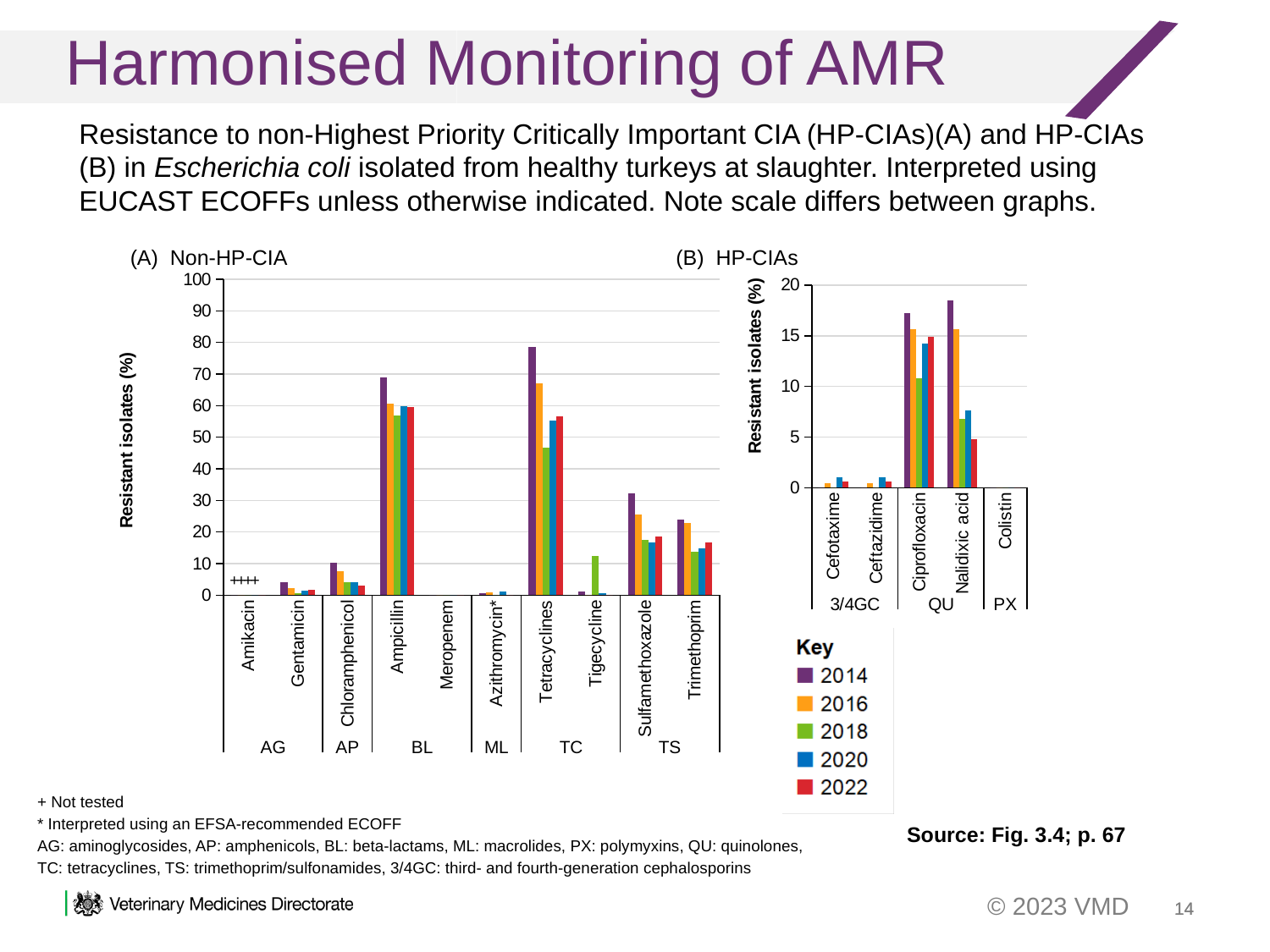
In chart (A) Non-HP-CIA, is the 2018 value for Tetracyclines greater or less than 50? less In chart (B) HP-CIAs, is the 2014 value for Nalidixic acid greater or less than 15? greater In chart (B) HP-CIAs, do the Nalidixic acid values rise or fall from 2014 to 2022? fall How many antimicrobials are shown on the x axis of chart (A) Non-HP-CIA? 10 In chart (B) HP-CIAs, which antimicrobial has the highest 2014 bar? Nalidixic acid How many years does the key list? 5 What is the y-axis label of chart (A) Non-HP-CIA? Resistant isolates (%) In chart (A) Non-HP-CIA, is the 2014 value for Ampicillin greater or less than 60? greater In chart (A) Non-HP-CIA, which antimicrobial has the highest 2014 bar? Tetracyclines What kind of chart is chart (A) Non-HP-CIA? bar chart In chart (A) Non-HP-CIA, which is larger in 2014: Ampicillin or Tetracyclines? Tetracyclines How many antimicrobials are shown on the x axis of chart (B) HP-CIAs? 5